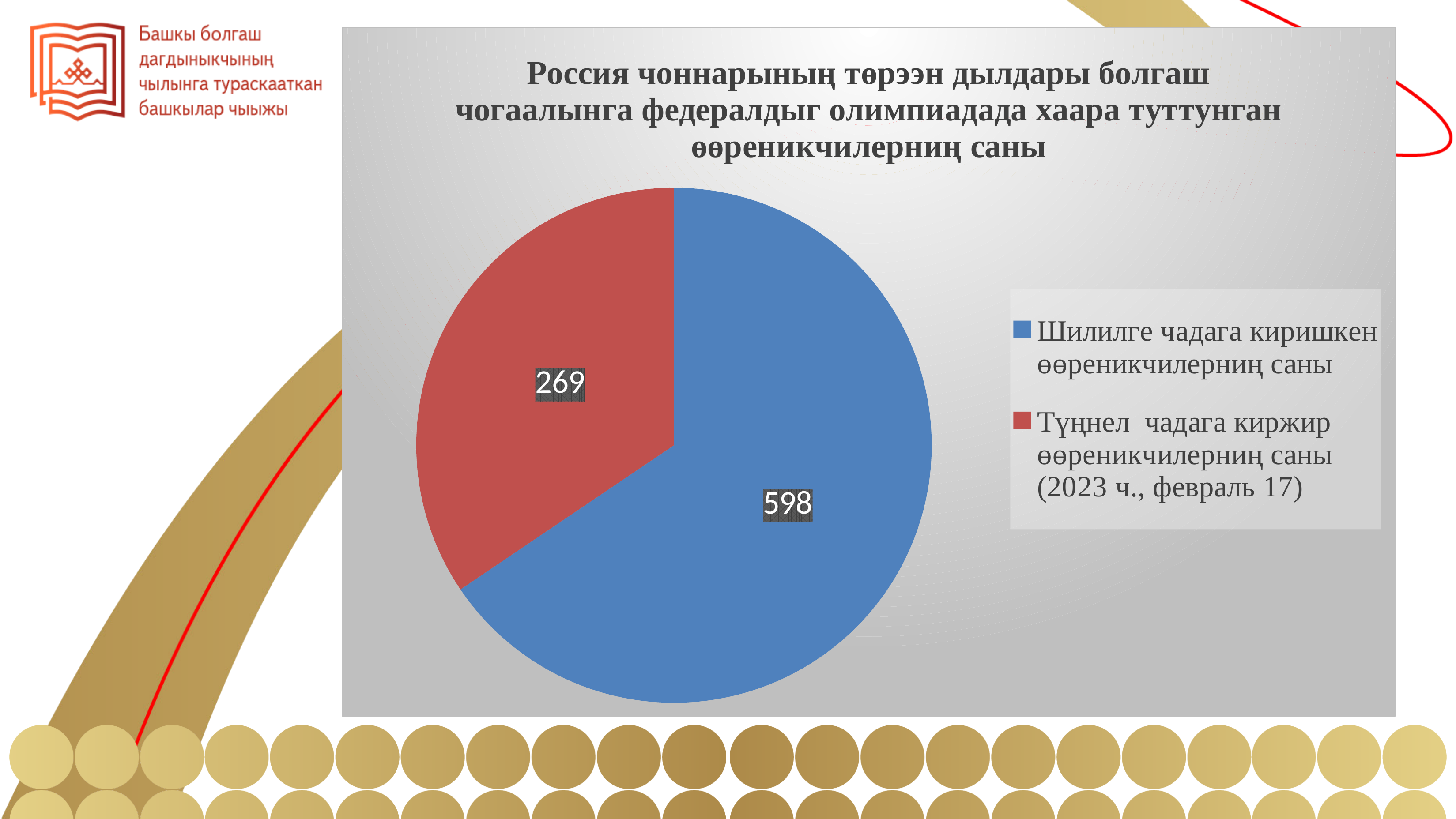
What is the total of the two values shown in the pie chart? 867 What is the value for "Шилилге чадага киришкен өөреникчилерниң саны"? 598 What share of the pie does the slice with value 598 represent, to the nearest percent? 69% What kind of chart is shown on the slide? pie chart Which slice of the pie is the smallest? Түңнел чадага киржир өөреникчилерниң саны (2023 ч., февраль 17) Which slice of the pie is the largest? Шилилге чадага киришкен өөреникчилерниң саны What colour is the slice for "Түңнел чадага киржир өөреникчилерниң саны (2023 ч., февраль 17)"? red How many slices does the pie chart have? 2 How many entries does the legend list? 2 Which is larger: the value for "Шилилге чадага киришкен өөреникчилерниң саны" or the value for "Түңнел чадага киржир өөреникчилерниң саны"? Шилилге чадага киришкен өөреникчилерниң саны What is the value for "Түңнел чадага киржир өөреникчилерниң саны (2023 ч., февраль 17)"? 269 What is the difference between the value for "Шилилге чадага киришкен өөреникчилерниң саны" and the value for "Түңнел чадага киржир өөреникчилерниң саны"? 329